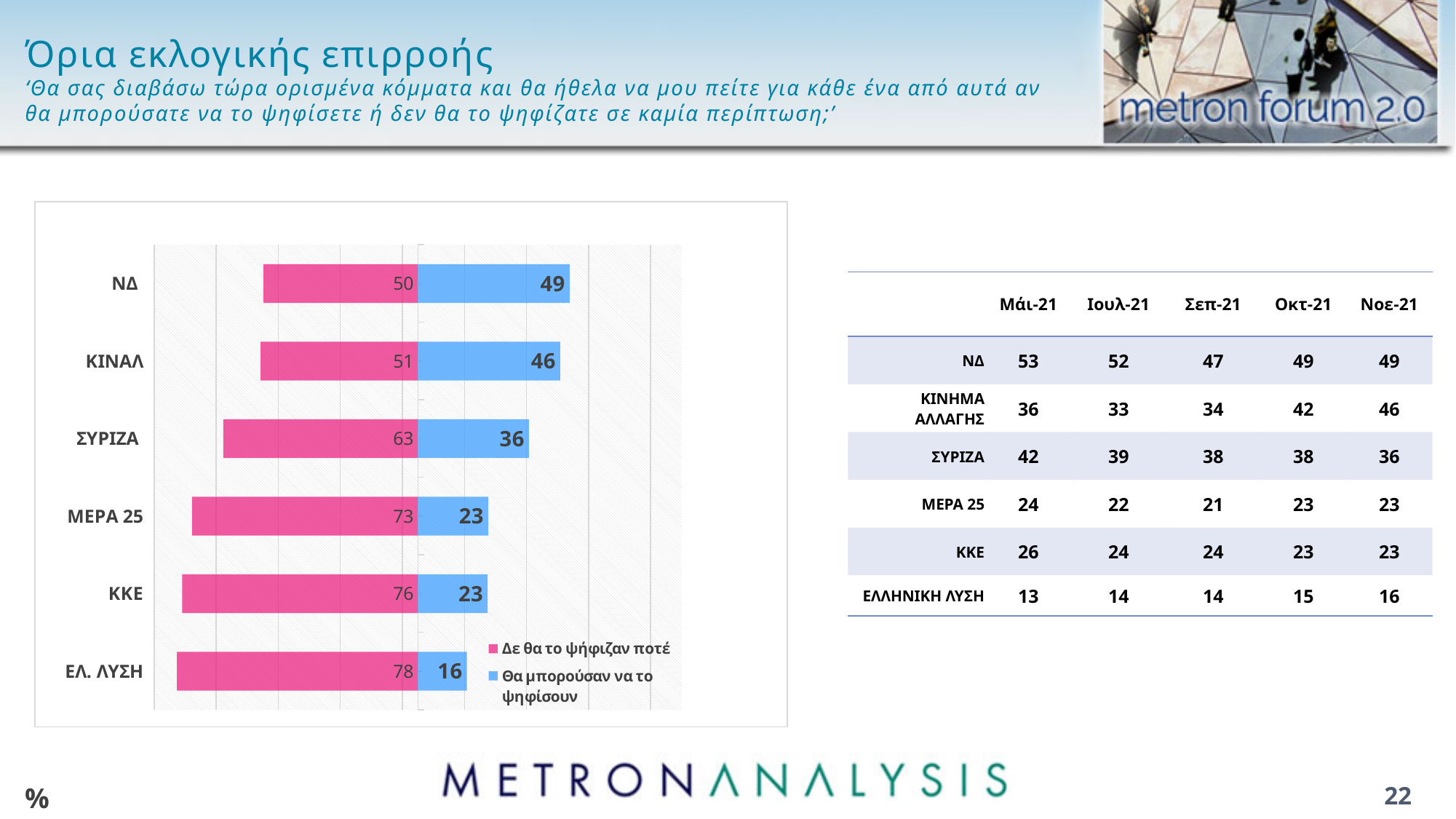
Which party has the highest 'Θα μπορούσαν να το ψηφίσουν' value in the bar chart? ΝΔ In the bar chart, what is the value of 'Θα μπορούσαν να το ψηφίσουν' for ΝΔ? 49 In the bar chart, which is larger: the 'Θα μπορούσαν να το ψηφίσουν' value for ΚΙΝΑΛ or for ΣΥΡΙΖΑ? ΚΙΝΑΛ How many parties (categories) are shown in the bar chart? 6 In the bar chart, which colour represents 'Δε θα το ψήφιζαν ποτέ'? pink Which party has the lowest 'Δε θα το ψήφιζαν ποτέ' value in the bar chart? ΝΔ In the bar chart, what is the value of 'Θα μπορούσαν να το ψηφίσουν' for ΕΛ. ΛΥΣΗ? 16 In the bar chart, what is the difference between the 'Δε θα το ψήφιζαν ποτέ' and 'Θα μπορούσαν να το ψηφίσουν' values for ΣΥΡΙΖΑ? 27 Which party has the highest 'Δε θα το ψήφιζαν ποτέ' value in the bar chart? ΕΛ. ΛΥΣΗ How many series does the legend of the bar chart list? 2 In the bar chart, what is the value of 'Δε θα το ψήφιζαν ποτέ' for ΣΥΡΙΖΑ? 63 What kind of chart is shown on the left of the slide? bar chart